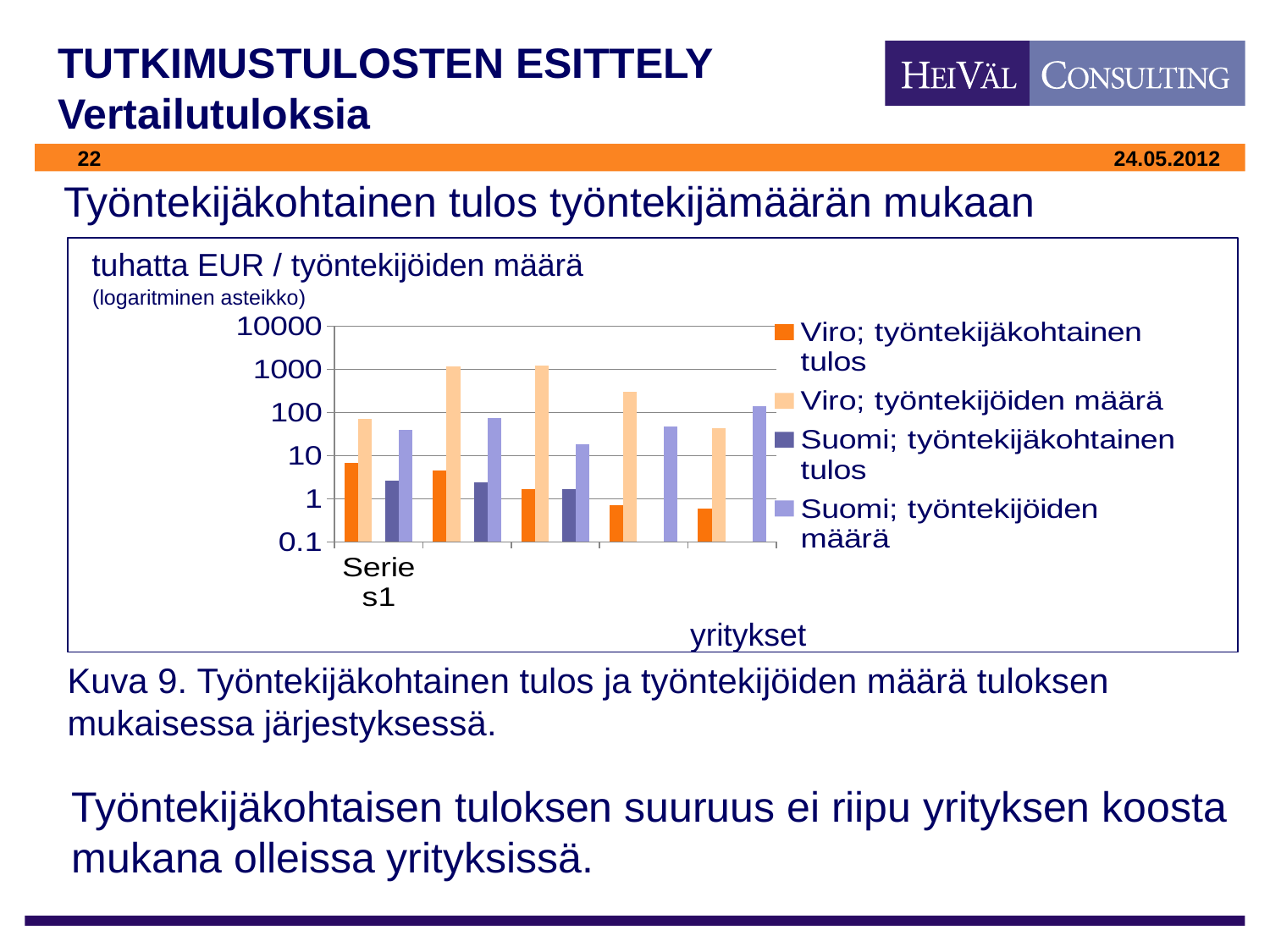
Is the value of 'Suomi; työntekijöiden määrä' in the third group greater or less than 100? less Is the value of 'Viro; työntekijöiden määrä' in the first (leftmost) group greater or less than 100? less Is the value of 'Viro; työntekijäkohtainen tulos' in the first (leftmost) group greater or less than 1? greater Does the 'Viro; työntekijäkohtainen tulos' series rise or fall from left to right across the groups? fall How many series does the chart legend list? 4 How many groups of bars are plotted along the x axis? 5 In the first (leftmost) group, which is larger: 'Viro; työntekijöiden määrä' or 'Suomi; työntekijöiden määrä'? Viro; työntekijöiden määrä What is the x-axis title of the chart? yritykset What kind of chart is shown on the slide? bar chart What type of scale does the chart's y axis use, according to the note above the chart? logaritminen asteikko